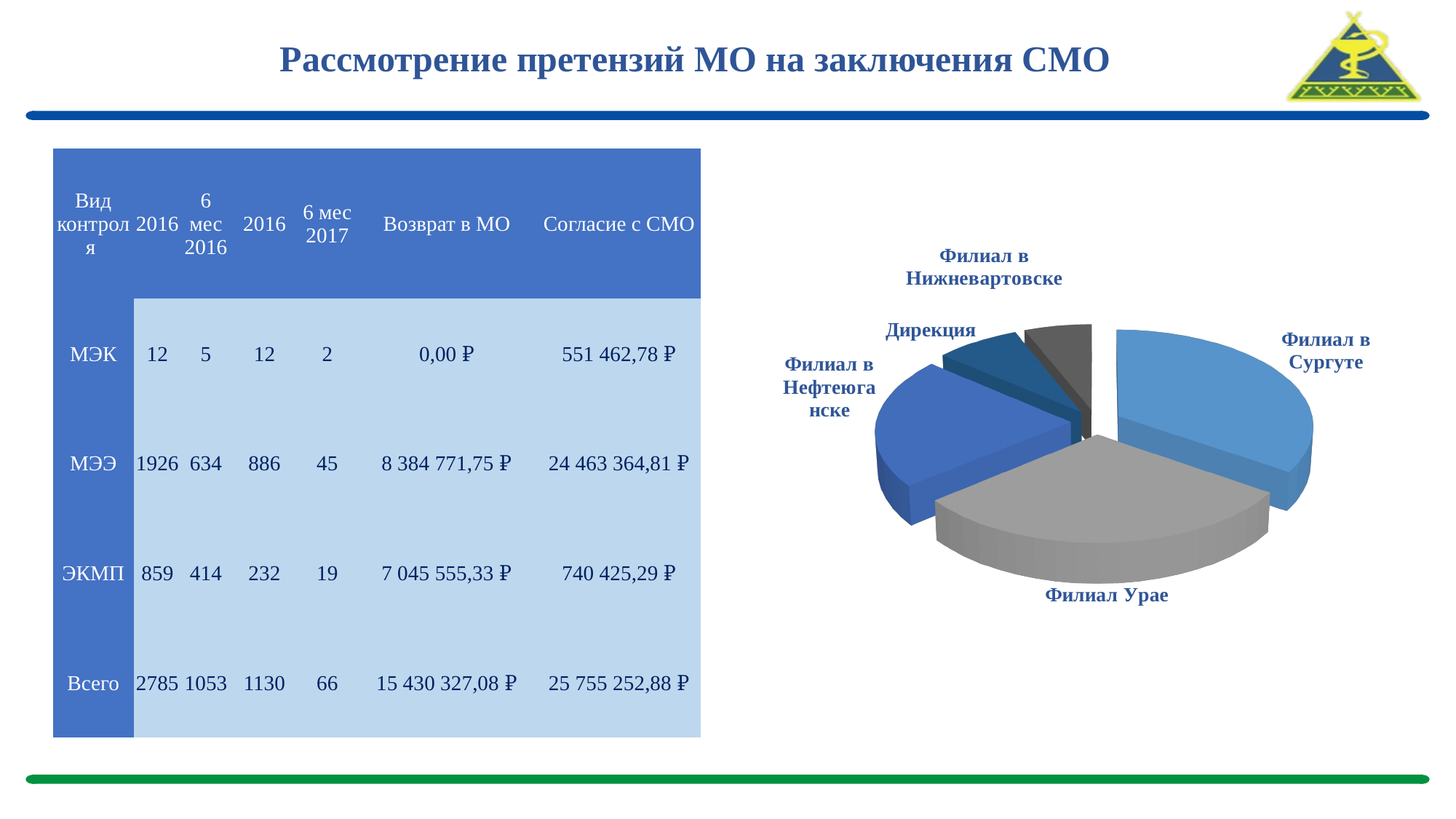
In the pie chart, which slice is larger: Филиал в Нефтеюганске or Филиал в Нижневартовске? Филиал в Нефтеюганске In the pie chart, which slice is larger: Филиал Урае or Дирекция? Филиал Урае Is the pie chart drawn in 3D? yes What colour is the Филиал Урае slice in the pie chart? gray In the pie chart, which slice is larger: Филиал Урае or Филиал в Сургуте? Филиал в Сургуте Which category has the largest slice in the pie chart? Филиал в Сургуте How many slices does the pie chart have? 5 What kind of chart is shown on the right side of the slide? pie chart